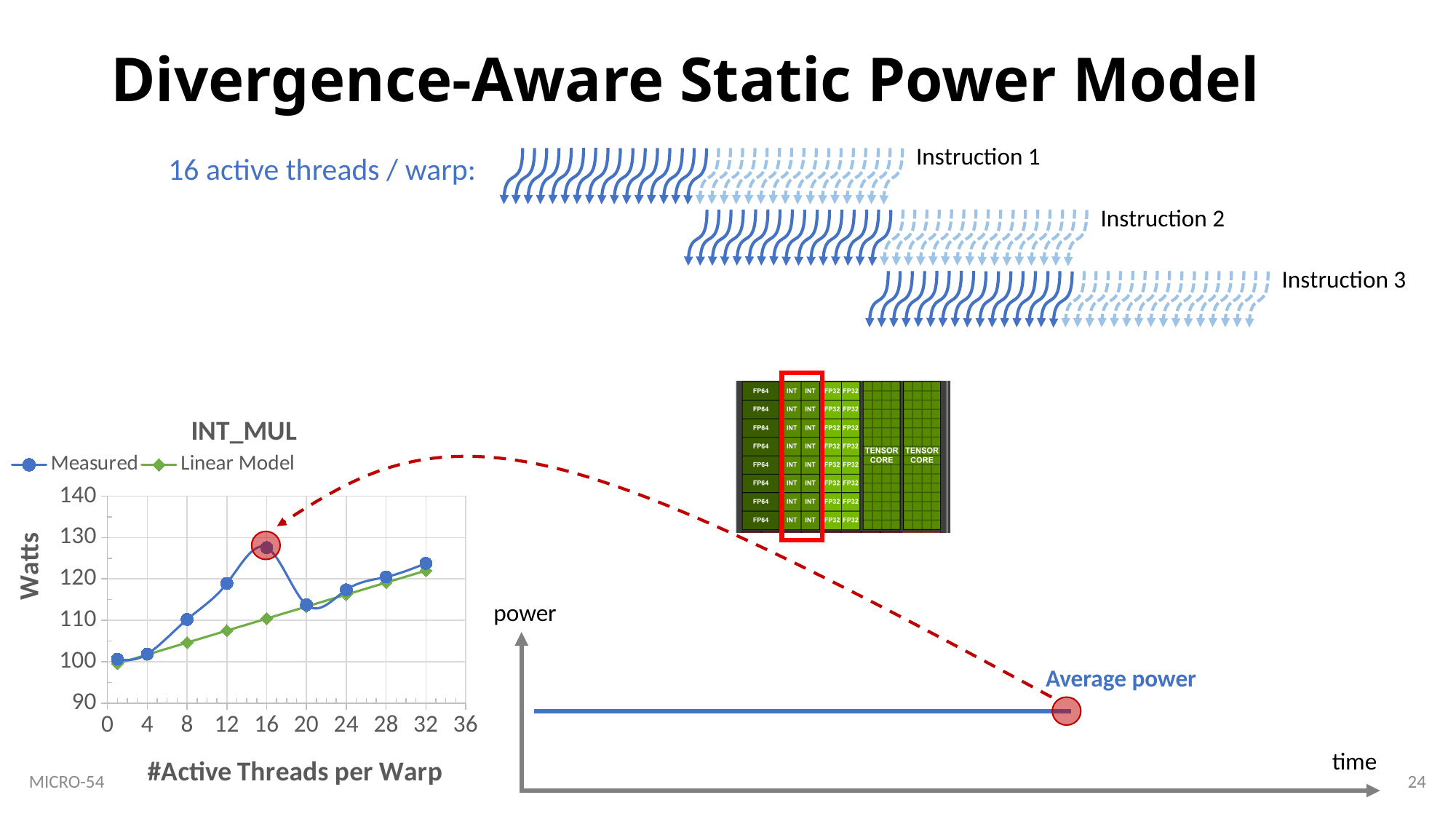
At 12 active threads per warp, which series has the larger value, Measured or Linear Model? Measured At which number of active threads per warp does the Measured series reach its highest value? 16 Does the Linear Model series rise or fall as the number of active threads per warp increases? rise What kind of chart is the INT_MUL chart? line chart Is the Measured value at 8 active threads per warp greater or less than 120 Watts? less How many series does the legend of the INT_MUL chart list? 2 How many data points does the Measured series have in the INT_MUL chart? 9 What is the title of the line chart on the slide? INT_MUL Is the Measured value at 16 active threads per warp greater or less than 120 Watts? greater Is the Linear Model value at 32 active threads per warp greater or less than 110 Watts? greater What are the two series named in the legend of the INT_MUL chart? Measured and Linear Model At 16 active threads per warp, which series has the larger value, Measured or Linear Model? Measured